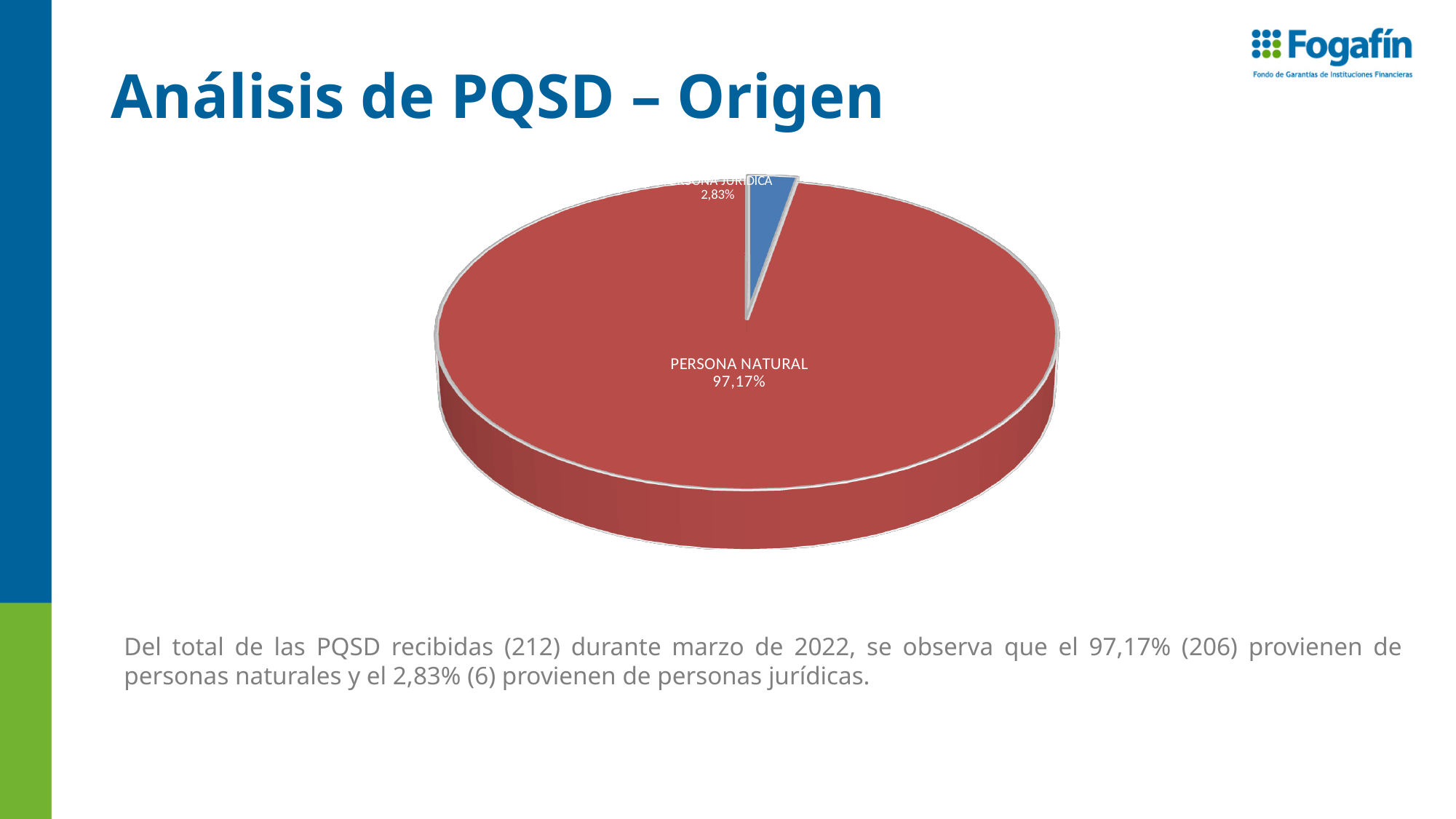
What is the difference in percentage points between the PERSONA NATURAL and PERSONA JURÍDICA slices? 94,34% What share of the pie does PERSONA NATURAL represent? 97,17% What colour is the PERSONA NATURAL slice? Red Which category has the smallest slice of the pie? PERSONA JURÍDICA Which is larger, the PERSONA NATURAL slice or the PERSONA JURÍDICA slice? PERSONA NATURAL How many slices does the pie chart have? 2 What kind of chart is shown on the slide? Pie chart What colour is the PERSONA JURÍDICA slice? Blue Is the share for PERSONA NATURAL greater or less than 90%? greater Is the share for PERSONA JURÍDICA greater or less than 5%? less Which category has the largest slice of the pie? PERSONA NATURAL What share of the pie does PERSONA JURÍDICA represent? 2,83%